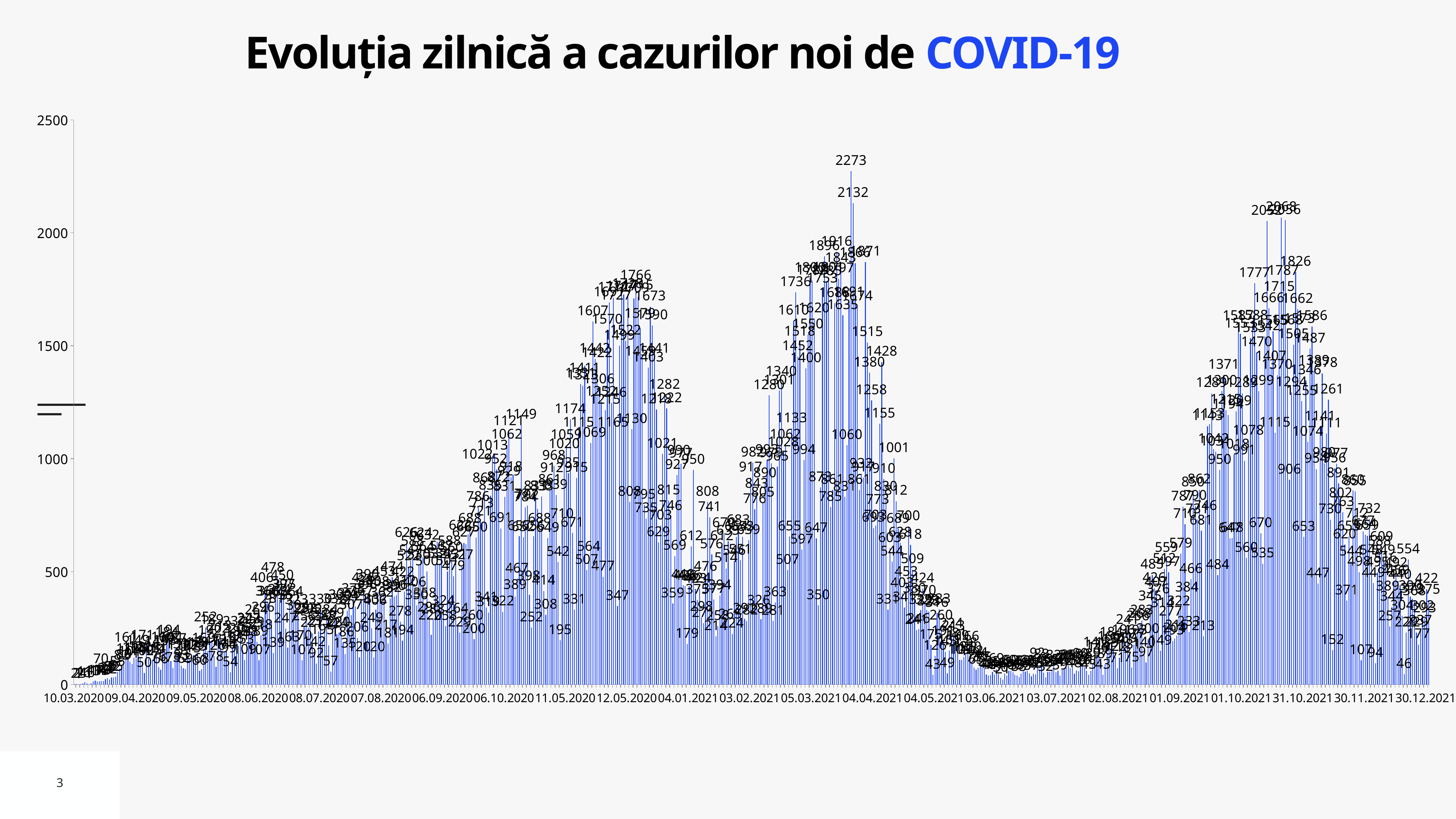
Do the values rise or fall between 02.08.2021 and 01.10.2021? rise What is the difference between the two highest labeled values, 2273 and 2132? 141 Do the values rise or fall between 04.04.2021 and 03.06.2021? fall What is the maximum value shown on the vertical axis? 2500 Are the daily values around 03.07.2021 greater or less than 500? less What is the first date label on the horizontal axis? 10.03.2020 What is the highest daily value labeled on the chart? 2273 What is the title of the chart? Evoluția zilnică a cazurilor noi de COVID-19 What kind of chart is shown on the slide? bar chart What is the second-highest value labeled on the chart, next to the 2273 peak? 2132 Is the highest peak of the chart greater or less than 2000? greater